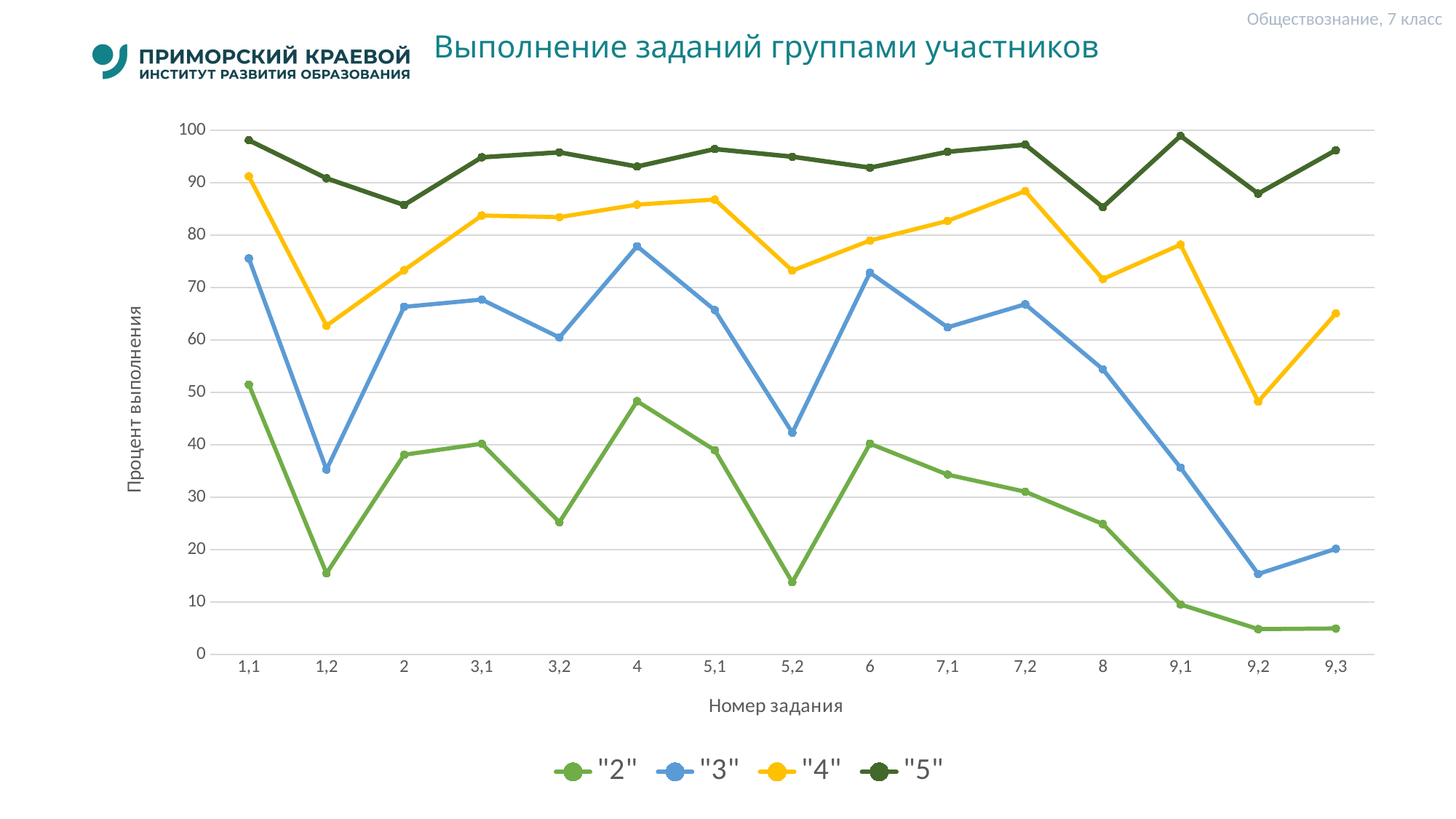
Which is larger for series "4": the value at task 7,2 or the value at task 8? 7,2 For which task number is the value of series "4" highest? 1,1 What kind of chart is shown on the slide? line chart Is the value for series "3" at task 4 greater or less than 70? greater How many series does the legend list? 4 For which task number is the value of series "3" lowest? 9,2 For which task number is the value of series "4" lowest? 9,2 Is the value for series "5" at task 8 greater or less than 90? less What is the title of the vertical axis? Процент выполнения For which task number is the value of series "2" highest? 1,1 Is the value for series "2" at task 1,2 greater or less than 20? less How many task numbers are plotted along the x axis? 15